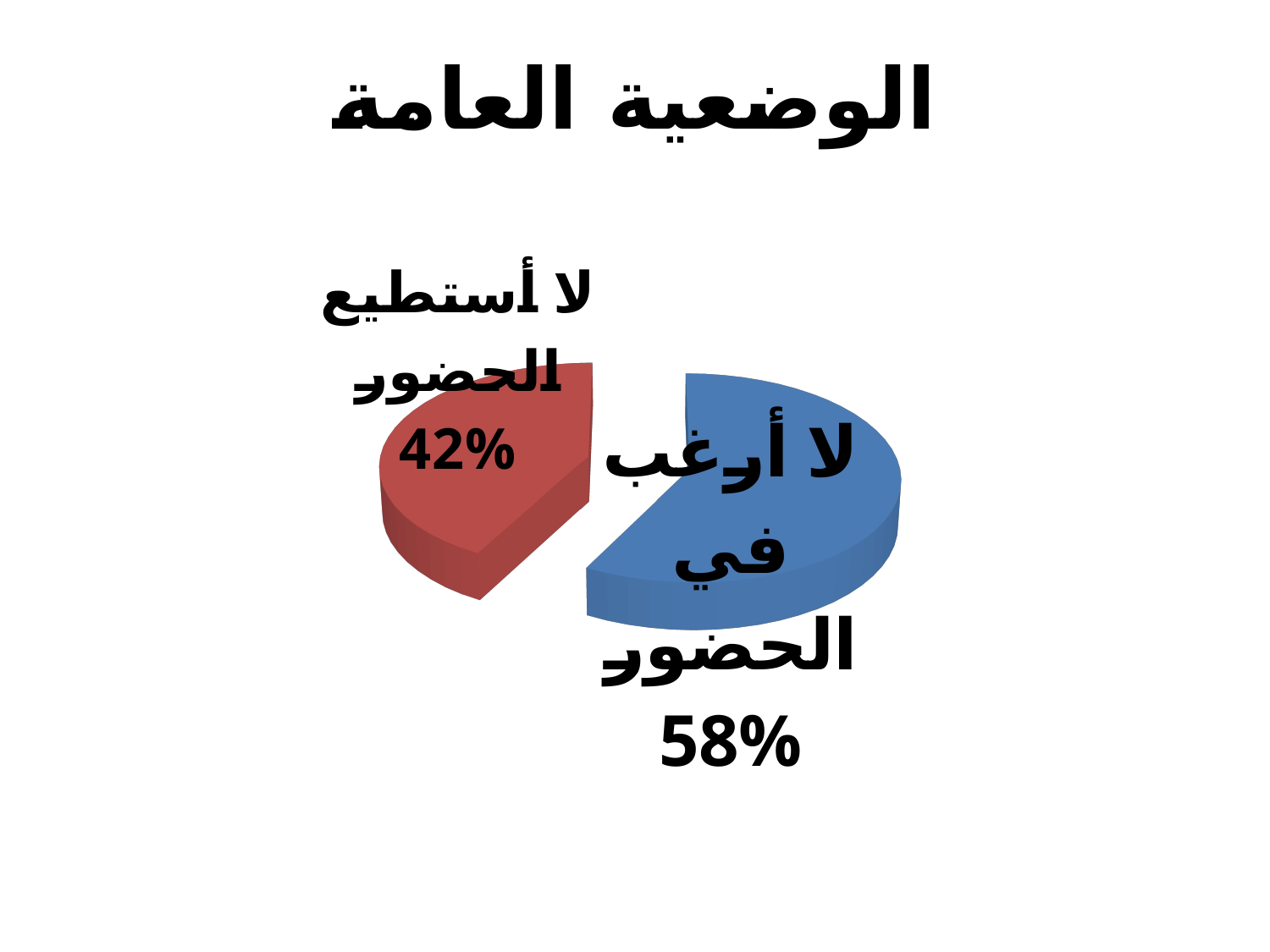
What percentage is shown for the slice labelled "لا أرغب في الحضور"? 58% How many slices does the pie chart have? 2 Which slice of the pie is the largest? لا أرغب في الحضور What kind of chart is shown on the slide? pie chart Which slice of the pie is the smallest? لا أستطيع الحضور What colour is the slice labelled "لا أستطيع الحضور"? red What is the difference in percentage points between the "لا أرغب في الحضور" slice and the "لا أستطيع الحضور" slice? 16 What share of the pie does the "لا أرغب في الحضور" slice represent? 58% What is the title of the chart? الوضعية العامة Which is larger: the share for "لا أستطيع الحضور" or the share for "لا أرغب في الحضور"? لا أرغب في الحضور What percentage is shown for the slice labelled "لا أستطيع الحضور"? 42%